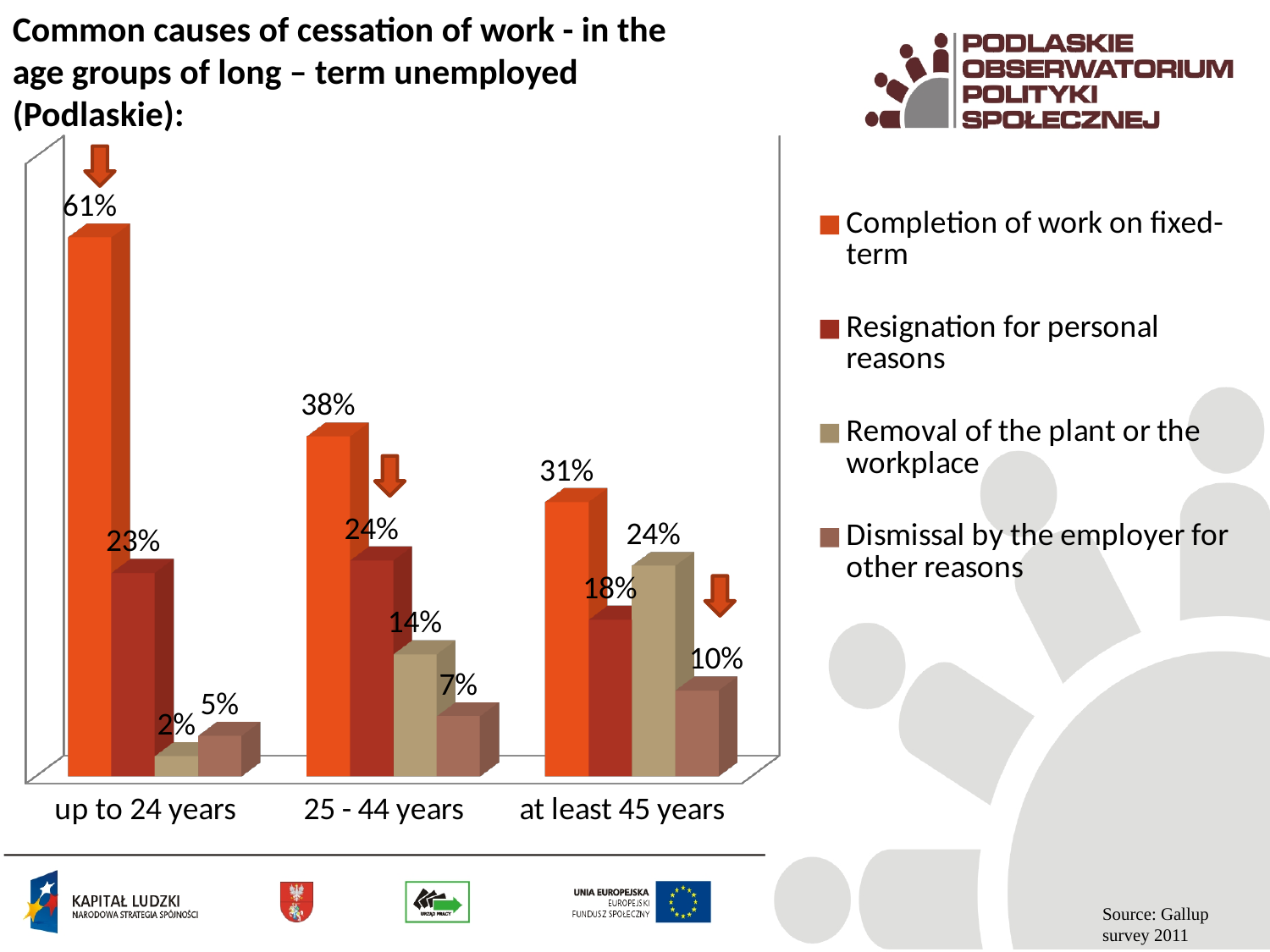
How does the value for Completion of work on fixed-term change across the age groups from left to right? It falls Which series is shown in orange in the legend? Completion of work on fixed-term What is the difference between Completion of work on fixed-term and Resignation for personal reasons in the up to 24 years group? 38% What is the value for Removal of the plant or the workplace in the 25 - 44 years group? 14% How many age groups are shown on the x axis? 3 Which age group has the highest value for Completion of work on fixed-term? up to 24 years What is the value for Completion of work on fixed-term in the up to 24 years group? 61% Which age group has the lowest value for Removal of the plant or the workplace? up to 24 years How many series does the legend list? 4 What kind of chart is shown on the slide? Bar chart In the at least 45 years group, which is larger: Resignation for personal reasons or Removal of the plant or the workplace? Removal of the plant or the workplace What is the value for Dismissal by the employer for other reasons in the at least 45 years group? 10%